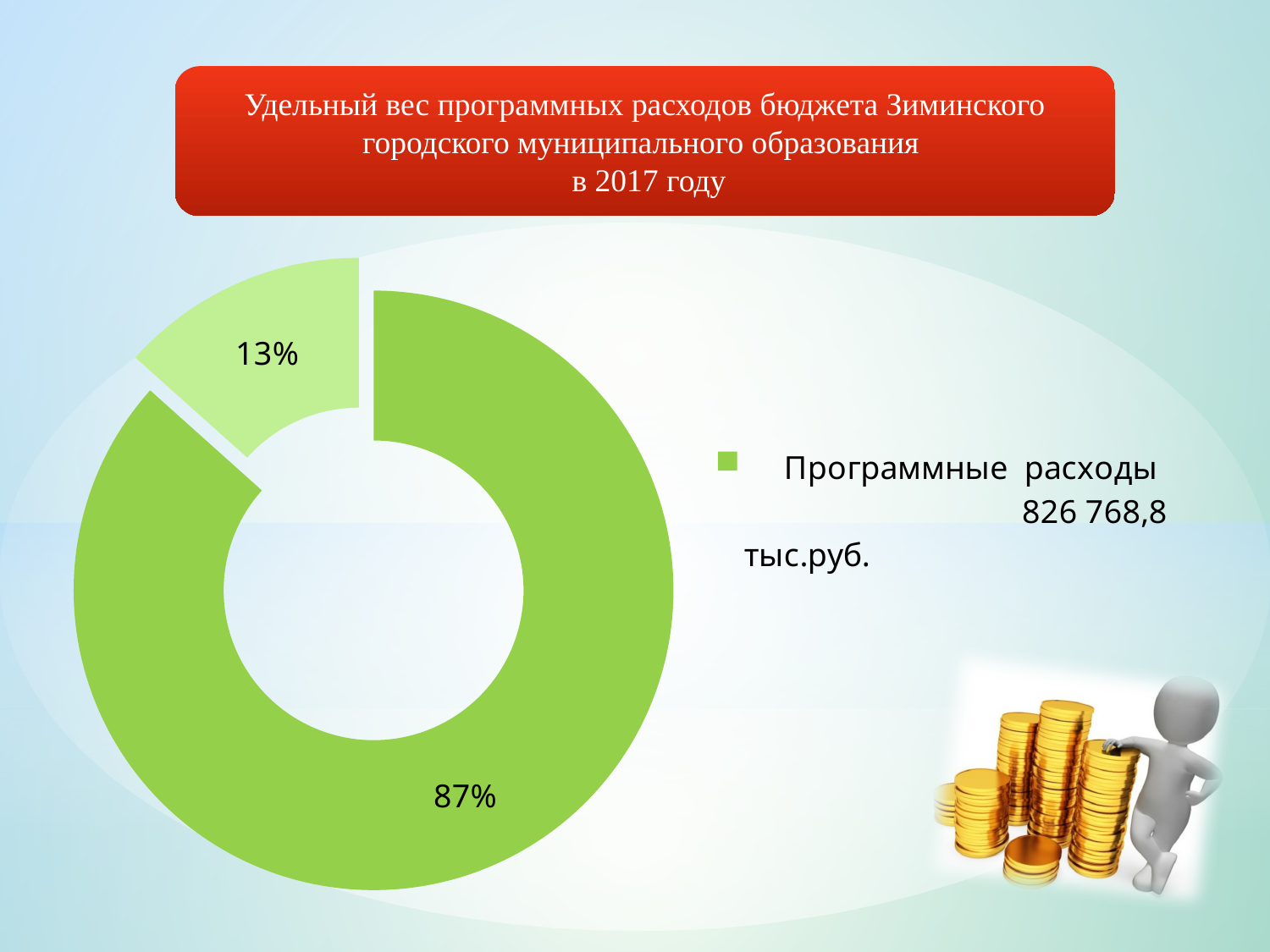
What percentage is shown on the larger, dark green slice of the chart? 87% What is the difference in percentage points between the two slices of the chart? 74 Which slice is larger: the one labelled 87% or the one labelled 13%? 87% What year does the chart title refer to? 2017 Is the share of the larger slice greater or less than 50%? greater What is the name of the legend entry shown next to the chart? Программные расходы How many slices does the chart have? 2 How many entries does the chart legend list? 1 What amount in тыс.руб. is given in the legend for "Программные расходы"? 826 768,8 тыс.руб. What share of the chart does the slice labelled "Программные расходы" represent? 87% What percentage is shown on the smaller, light green slice of the chart? 13% What kind of chart is shown on the slide? Doughnut chart